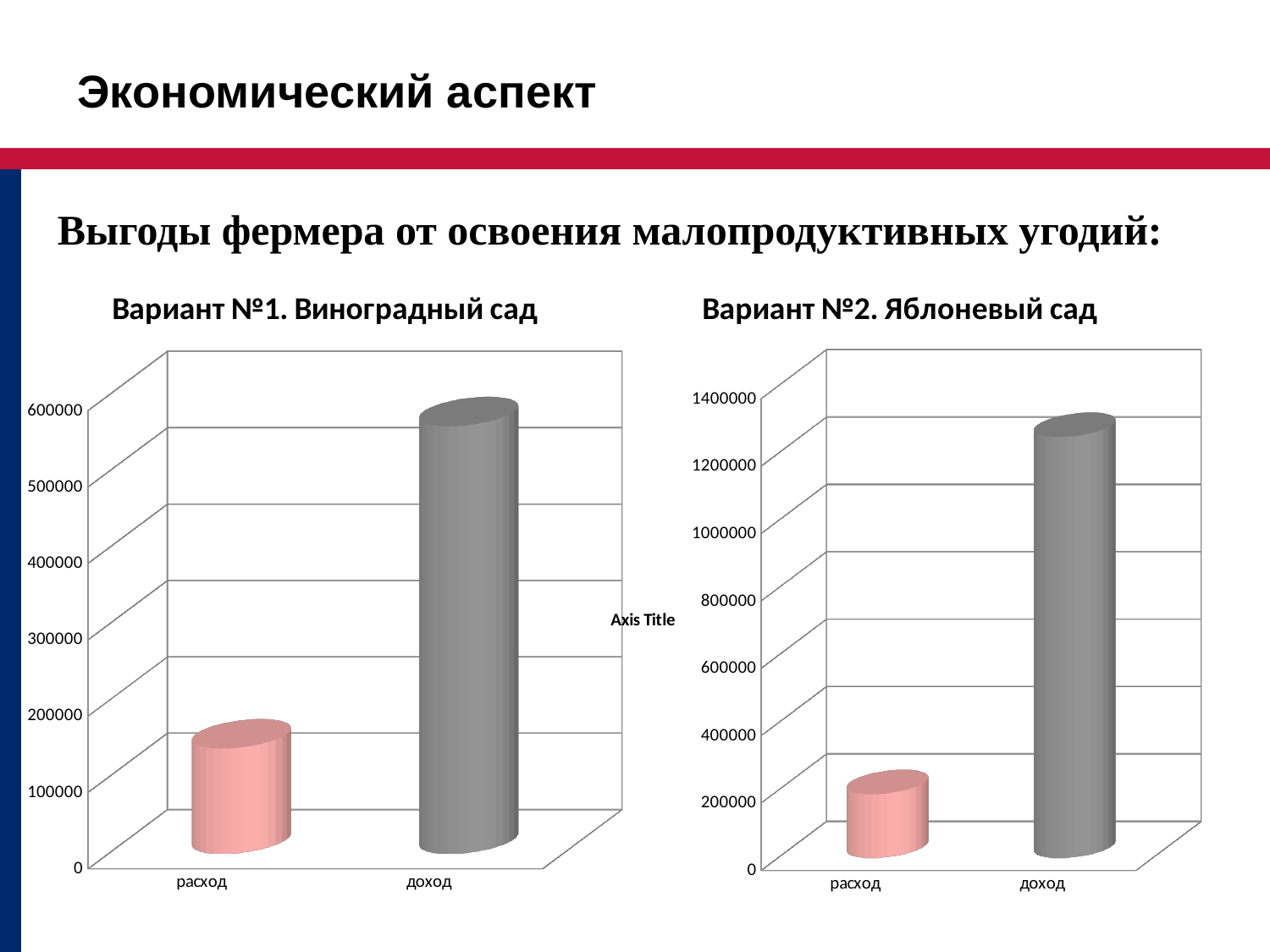
In the "Вариант №2. Яблоневый сад" chart, is the value for доход greater or less than 1000000? greater In the "Вариант №2. Яблоневый сад" chart, is the value for расход greater or less than 400000? less What is the title of the chart on the left side of the slide? Вариант №1. Виноградный сад In the "Вариант №1. Виноградный сад" chart, is the value for доход greater or less than 500000? greater In the "Вариант №2. Яблоневый сад" chart, which category has the lowest value? расход How many categories are shown on the x axis of the "Вариант №2. Яблоневый сад" chart? 2 In the "Вариант №2. Яблоневый сад" chart, which is larger, расход or доход? доход In the "Вариант №1. Виноградный сад" chart, what colour is the bar for расход? pink What kind of chart is "Вариант №1. Виноградный сад"? bar chart In the "Вариант №1. Виноградный сад" chart, which category has the highest value? доход